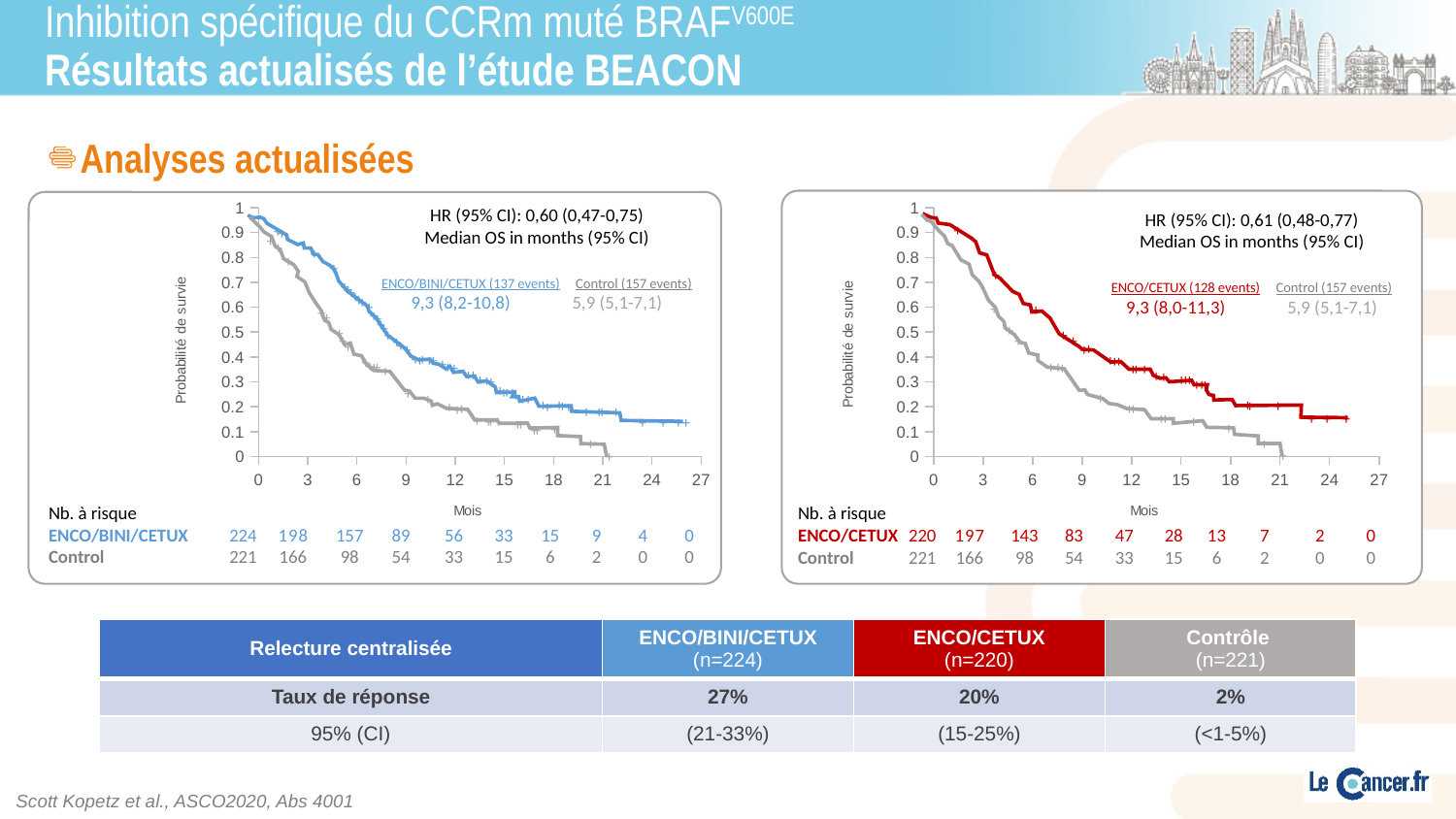
In the left chart, does the survival probability rise or fall as months increase? fall In the right chart, which arm has more patients at risk at 12 months, ENCO/CETUX or Control? ENCO/CETUX In the right chart, how many patients are at risk in the ENCO/CETUX arm at 6 months? 143 In the left chart, what is the difference between the number at risk for ENCO/BINI/CETUX and Control at 0 months? 3 In the right chart, what is the HR (95% CI) shown? 0,61 (0,48-0,77) In the left chart, how many events are reported for the Control arm? 157 events What colour is the ENCO/CETUX curve in the right chart? red What kind of chart is shown in the left panel of the slide? line chart (Kaplan-Meier survival curve) How many survival curves (series) are plotted in the right chart? 2 In the right chart, is the survival probability for Control at 12 months greater or less than 0.3? less In the left chart, is the survival probability for ENCO/BINI/CETUX at 12 months greater or less than 0.5? less In the left chart, what is the median OS in months for ENCO/BINI/CETUX? 9,3 (8,2-10,8)